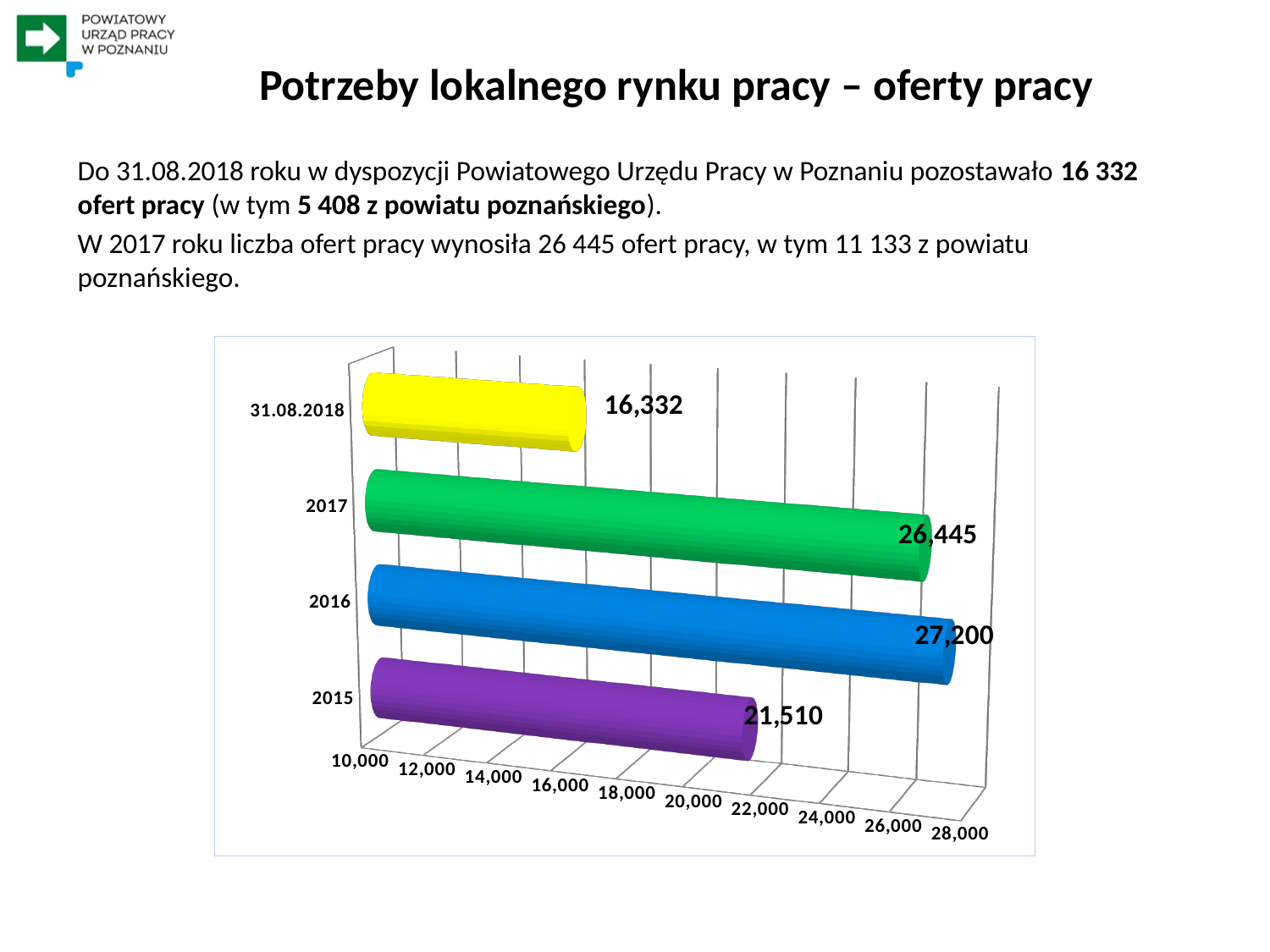
What is the value for 2015? 21,510 Which is larger, the value for 2015 or the value for 2017? 2017 What is the value for 31.08.2018? 16,332 What is the difference between the values for 2017 and 31.08.2018? 10,113 What is the value for 2016? 27,200 Which category has the lowest value? 31.08.2018 What kind of chart is shown on the slide? bar chart Which category has the highest value? 2016 Is the value for 2015 greater or less than 20,000? greater What is the difference between the values for 2016 and 2017? 755 What is the value for 2017? 26,445 How many categories are shown in the chart? 4